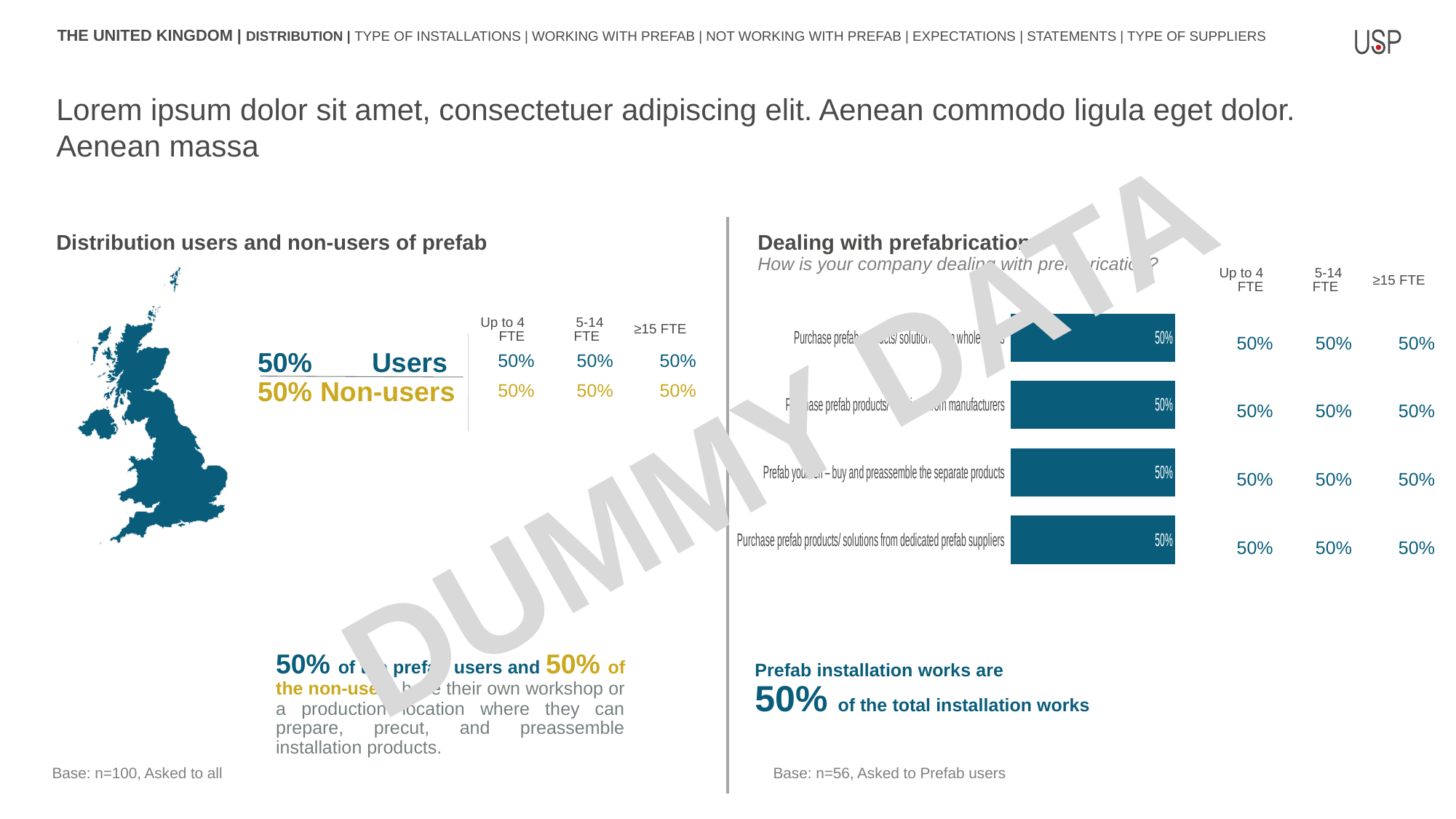
Do the values in the 'Dealing with prefabrication' chart differ from bar to bar, or are they all the same? all the same What kind of chart is shown under 'Dealing with prefabrication'? bar chart How many bars does the 'Dealing with prefabrication' chart show? 4 In the 'Dealing with prefabrication' chart, what is the value for 'Purchase prefab products/ solutions from dedicated prefab suppliers'? 50% In the 'Dealing with prefabrication' chart, what is the difference between the value for 'Purchase prefab products/ solutions from dedicated prefab suppliers' and the value on the top bar? 0% In the 'Dealing with prefabrication' chart, what value is printed on the top bar? 50% What is the title of the bar chart on the right side of the slide? Dealing with prefabrication In the 'Dealing with prefabrication' chart, what value is printed on the bottom bar? 50% In the 'Dealing with prefabrication' chart, what value is printed on the third bar from the top? 50% What colour are the bars in the 'Dealing with prefabrication' chart? dark blue